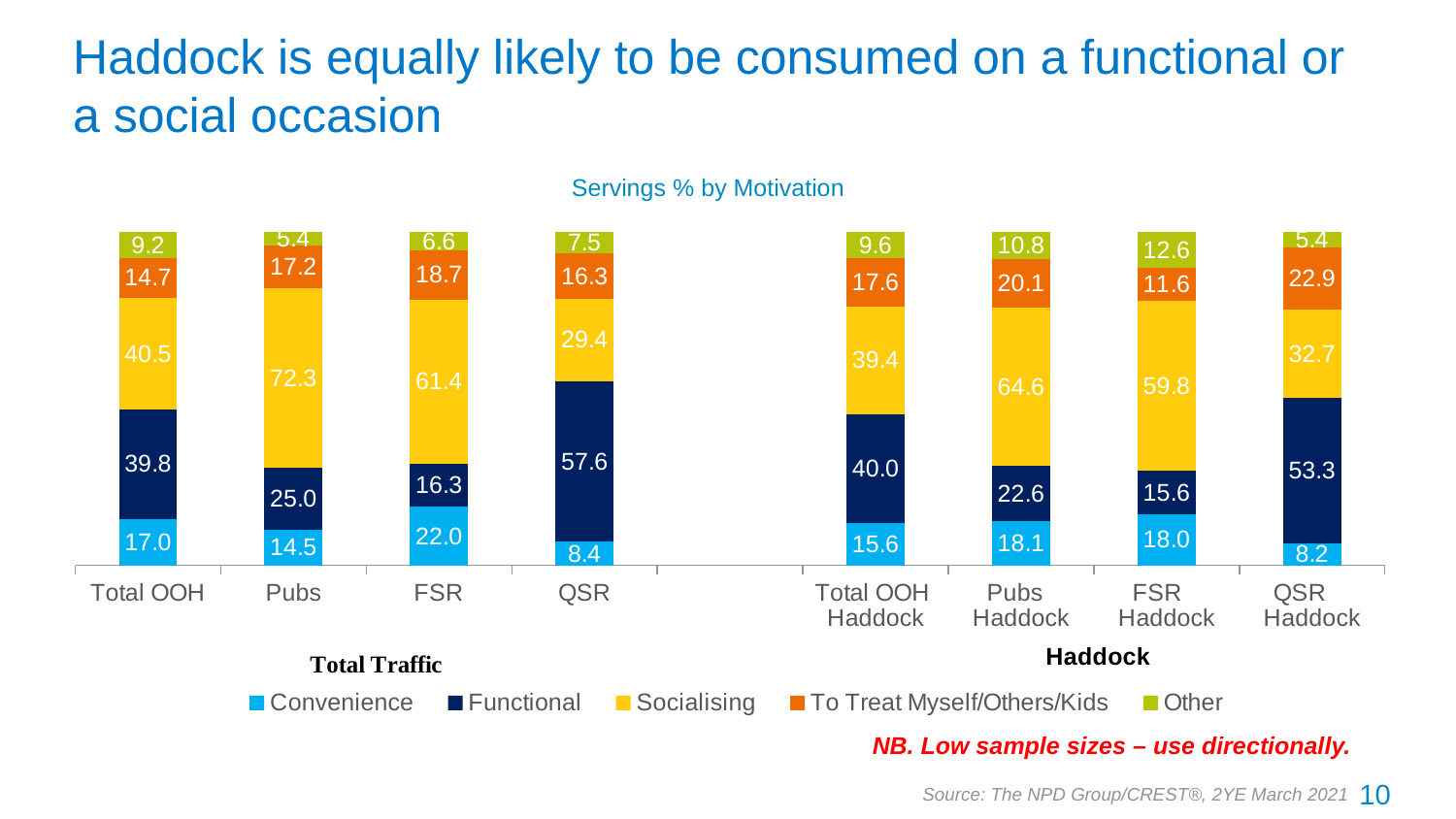
What is the To Treat Myself/Others/Kids value for FSR Haddock? 11.6 What is the Socialising value for Pubs Haddock? 64.6 What is the difference between the Functional values for QSR and QSR Haddock? 4.3 What kind of chart is shown on the slide? Stacked bar chart Which category has the highest Socialising value? Pubs How many categories are shown on the x axis? 8 How many series does the legend list? 5 What is the title of the chart? Servings % by Motivation What is the Convenience value for QSR? 8.4 Which category has the highest Functional value? QSR What is the Functional value for Total OOH? 39.8 Which has the larger Convenience value, FSR or FSR Haddock? FSR